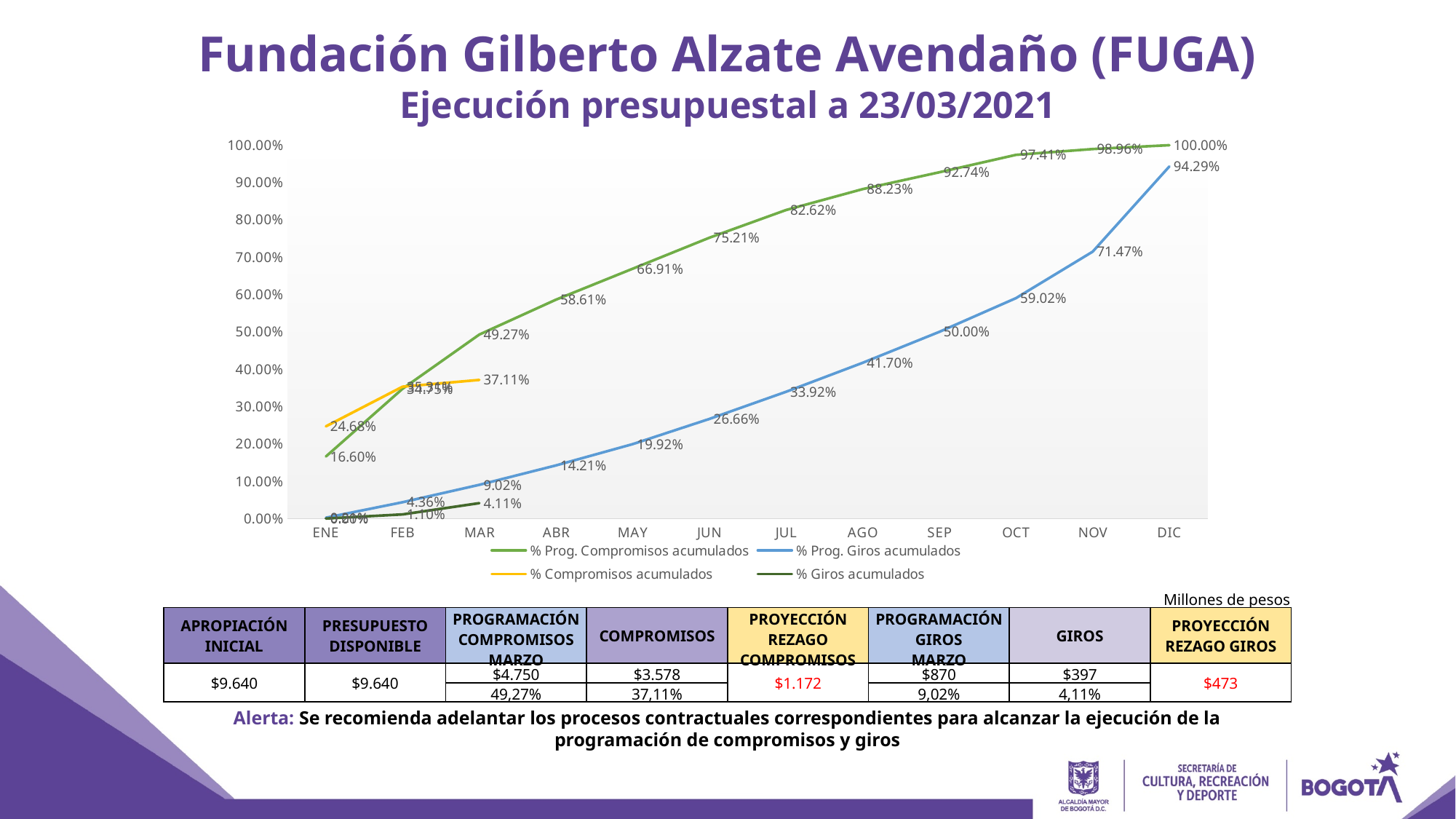
Does % Prog. Giros acumulados rise or fall from ENE to DIC? rise What type of chart is shown on the slide? line chart In which month does % Prog. Compromisos acumulados reach its highest value? DIC Which is larger in MAR: % Prog. Giros acumulados or % Giros acumulados? % Prog. Giros acumulados What is the value of % Prog. Giros acumulados in DIC? 94.29% What is the value of % Compromisos acumulados in MAR? 37.11% Is the value of % Prog. Giros acumulados in SEP greater or less than 40.00%? greater What is the value of % Giros acumulados in FEB? 1.10% What is the value of % Prog. Compromisos acumulados in MAR? 49.27% How many months are shown on the x axis of the chart? 12 How many series does the chart legend list? 4 What is the difference between % Prog. Compromisos acumulados and % Compromisos acumulados in MAR? 12.16%